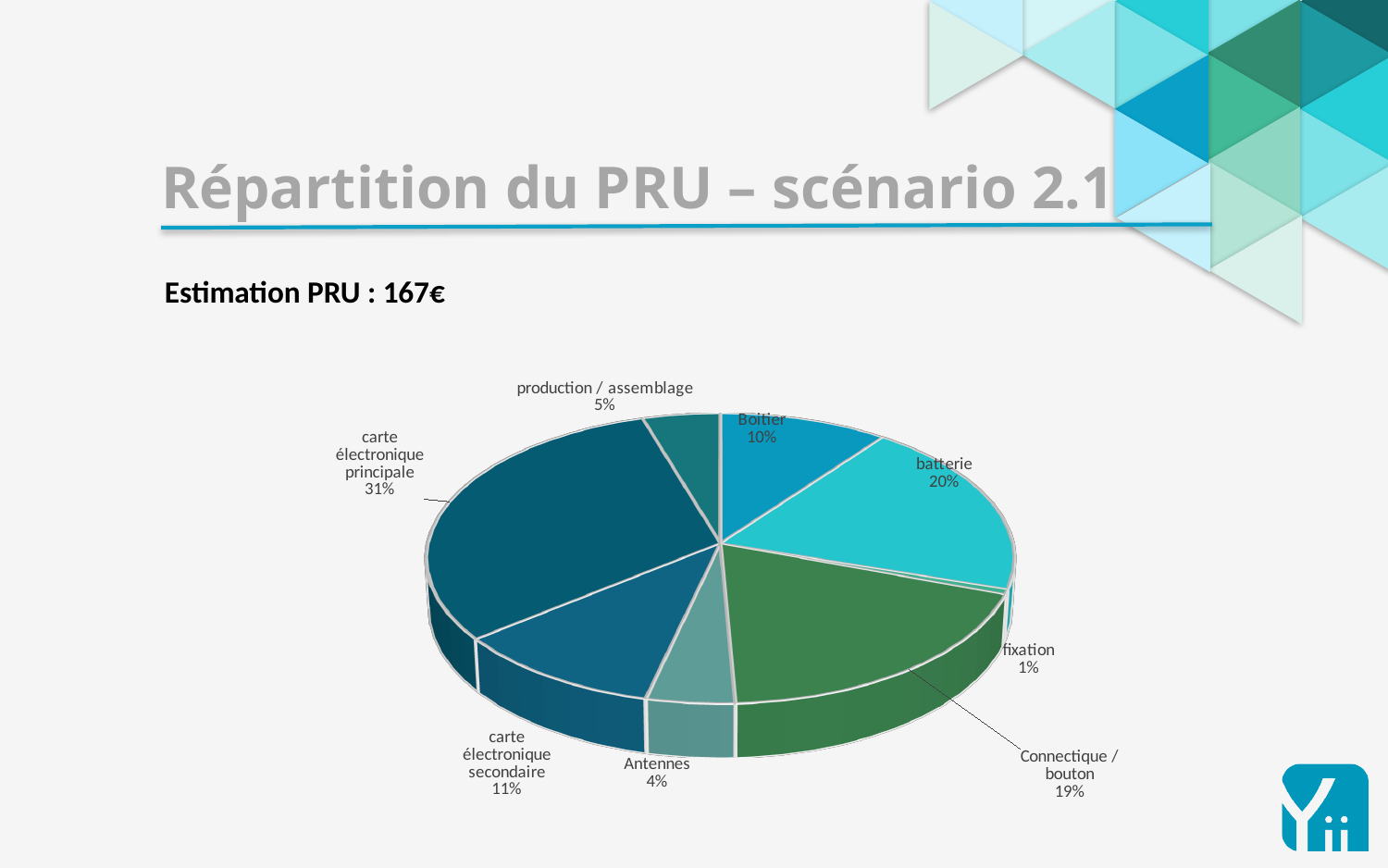
How many slices does the pie chart have? 8 What is the value shown for 'Connectique / bouton'? 19% What is the value shown for 'Boitier'? 10% What is the title of the slide containing the pie chart? Répartition du PRU – scénario 2.1 What is the value shown for 'production / assemblage'? 5% What share of the pie does 'carte électronique principale' represent? 31% What is the difference between the shares of 'batterie' and 'Boitier'? 10% What share of the pie does 'batterie' represent? 20% What kind of chart is shown on the slide? pie chart Which slice of the pie is the largest? carte électronique principale Which is larger, the share for 'Antennes' or the share for 'carte électronique secondaire'? carte électronique secondaire Which slice of the pie is the smallest? fixation